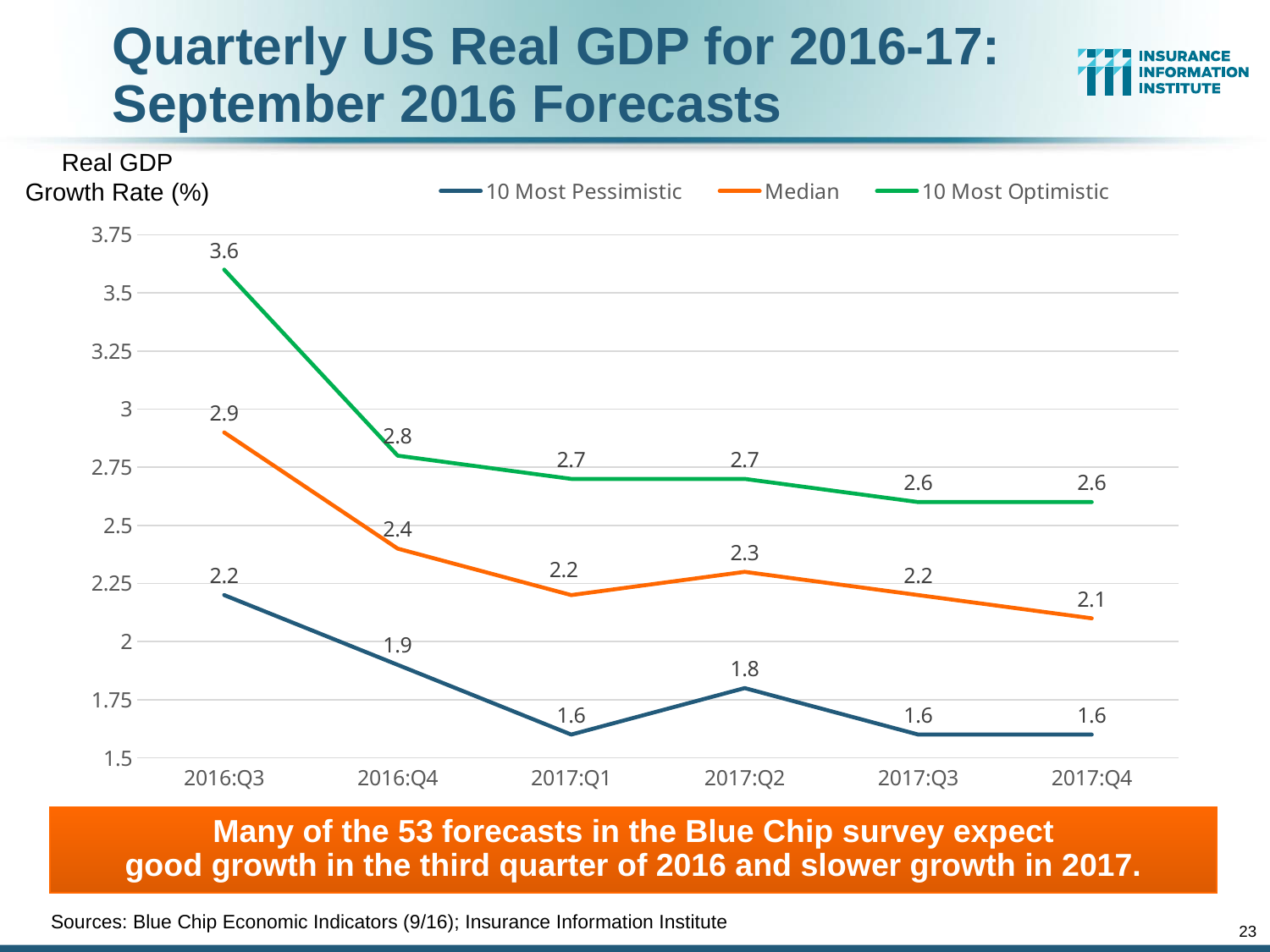
What is the difference between the 10 Most Optimistic and 10 Most Pessimistic forecasts for 2016:Q3? 1.4 In which quarter is the 10 Most Optimistic forecast highest? 2016:Q3 What is the Median forecast for 2016:Q4? 2.4 What is the 10 Most Optimistic forecast for 2016:Q3? 3.6 How many quarters are shown on the x axis? 6 What kind of chart is this? Line chart Does the 10 Most Optimistic series generally rise or fall from 2016:Q3 to 2017:Q4? Fall Which is larger, the Median forecast for 2017:Q2 or for 2017:Q3? 2017:Q2 What is the 10 Most Pessimistic forecast for 2017:Q2? 1.8 What colour is the Median line? Orange What is the lowest value of the Median series? 2.1 How many series does the legend list? 3